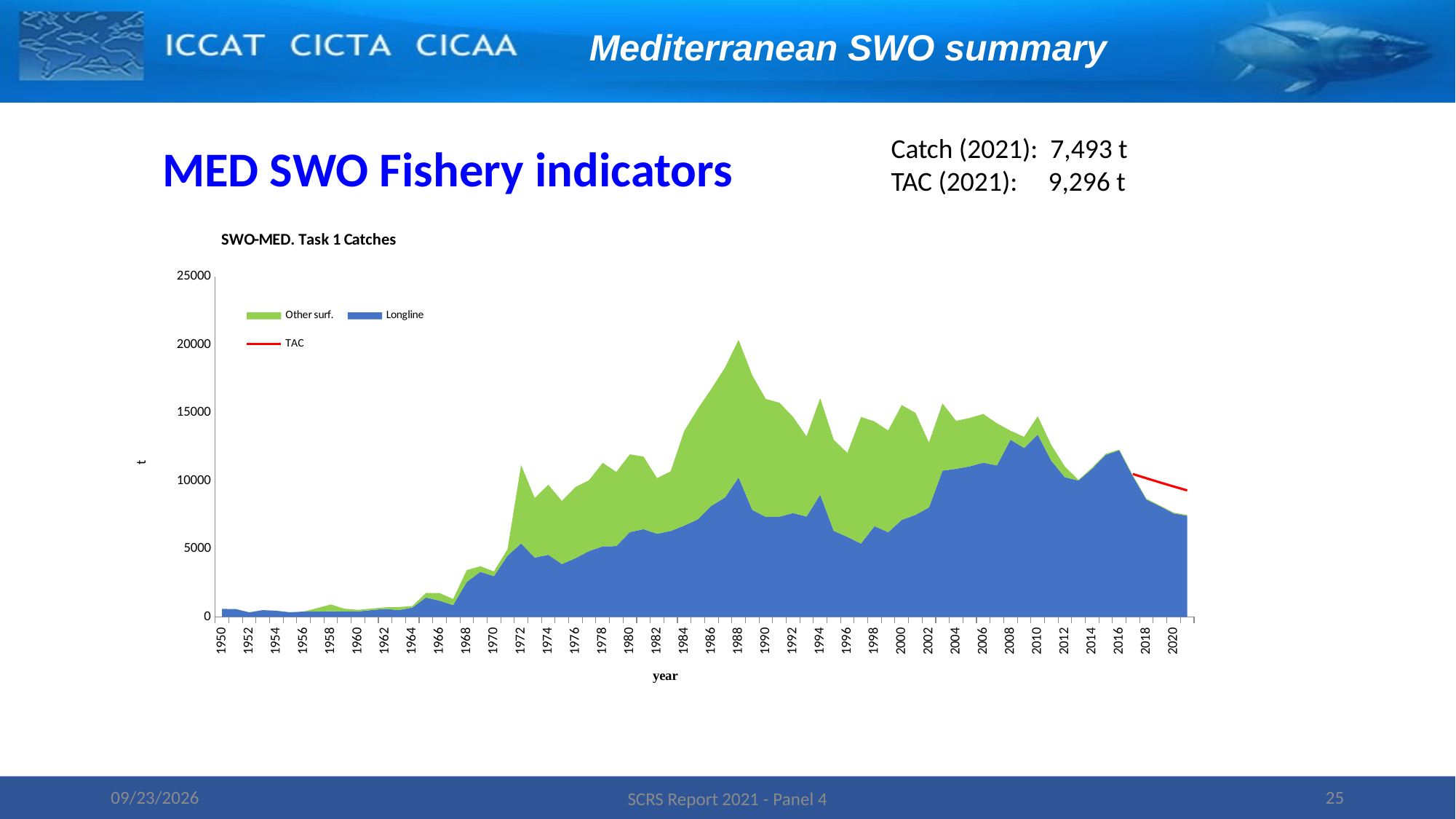
Which year has the larger total catch, 1988 or 2020? 1988 In which year does the total catch (Longline plus Other surf.) reach its highest point? 1988 Is the TAC line value in 2021 greater or less than 10000? less Is the total catch in 1950 greater or less than 5000? less What kind of chart is the SWO-MED. Task 1 Catches chart? area chart Is the total catch in 1988 greater or less than 15000? greater Do total catches rise or fall between 2016 and 2021? fall How many series does the legend of the SWO-MED. Task 1 Catches chart list? 3 What is the title of the chart on the slide? SWO-MED. Task 1 Catches Do total catches rise or fall between 1950 and 1972? rise What colour is the TAC series drawn in on the chart? red